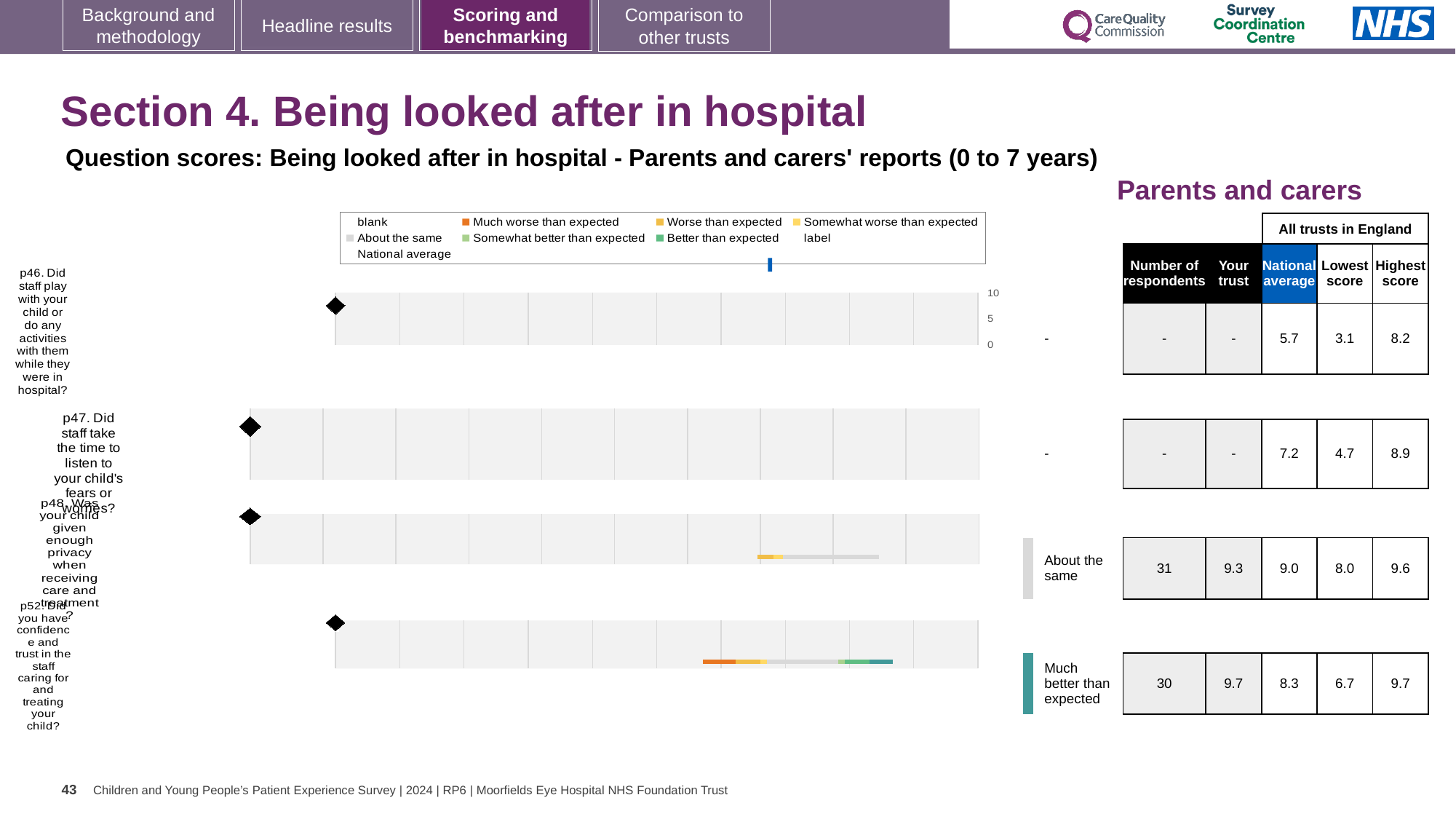
What benchmark category is shown for p52? Much better than expected What is the 'Your trust' score for p48 (Was your child given enough privacy when receiving care and treatment?)? 9.3 What is the national average for p46 (Did staff play with your child or do any activities with them while they were in hospital?)? 5.7 Which is larger for p48: the trust's score or the national average? the trust's score How many respondents answered p52? 30 Which question has the lowest national average? p46 How many questions (categories) are plotted in the chart? 4 What is the 'Your trust' score for p52 (Did you have confidence and trust in the staff caring for and treating your child?)? 9.7 What is the highest score across all trusts in England for p47 (Did staff take the time to listen to your child's fears or worries?)? 8.9 What is the difference between the trust's score and the national average for p52? 1.4 How many entries does the chart legend list? 9 What kind of chart is shown on the slide? bar chart